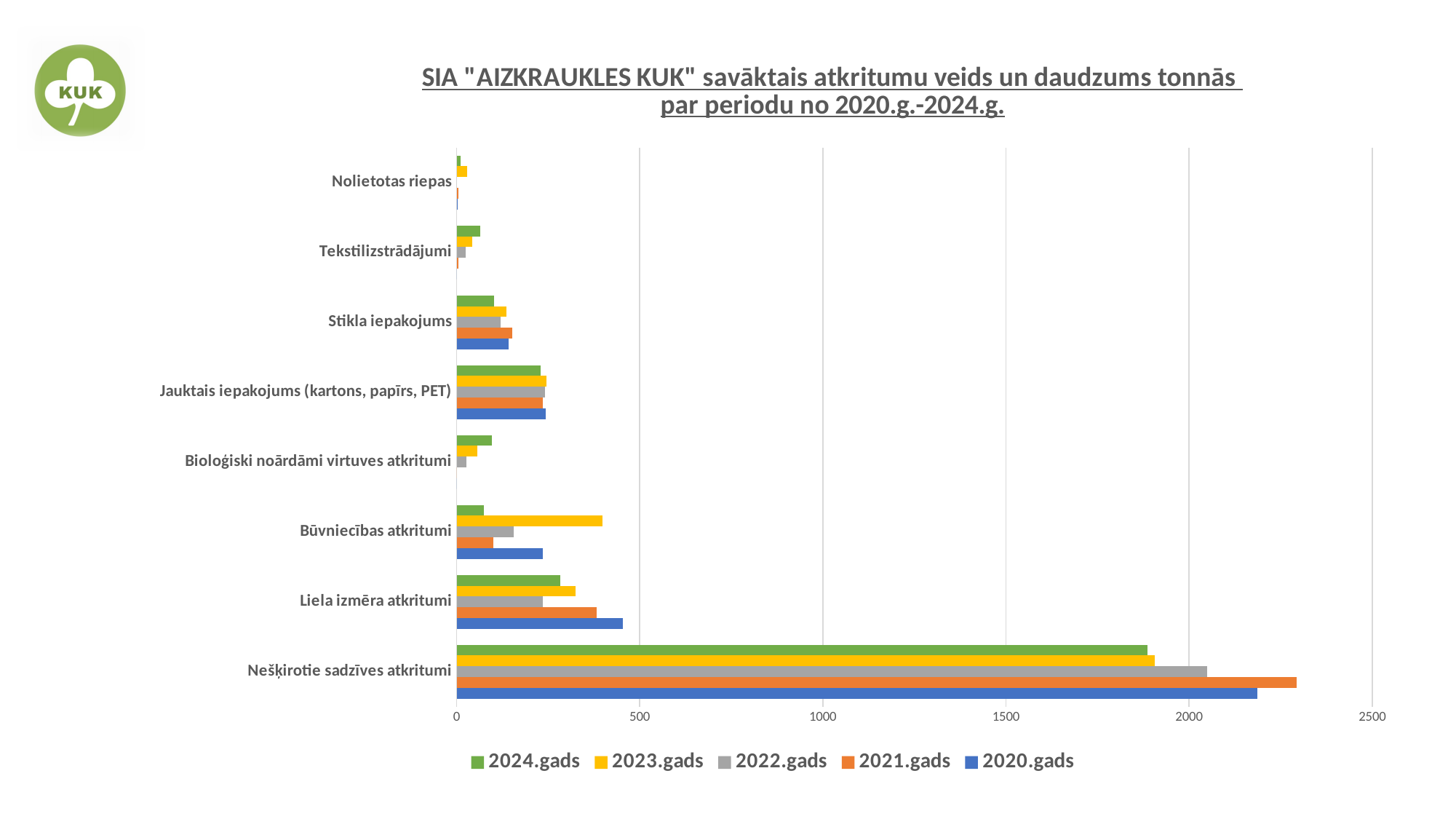
Which colour represents 2022.gads in the legend? grey Which waste category has the largest values in the chart? Nešķirotie sadzīves atkritumi Is the 2024.gads value for Nešķirotie sadzīves atkritumi greater or less than 2000? less How many waste categories are listed on the vertical axis of the chart? 8 How many series does the legend list? 5 Is the 2020.gads value for Liela izmēra atkritumi greater or less than 500? less What kind of chart is shown on the slide? bar chart For Būvniecības atkritumi, which is larger: the 2023.gads value or the 2020.gads value? 2023.gads Is the 2021.gads value for Nešķirotie sadzīves atkritumi greater or less than 2000? greater Which waste category has the smallest values in the chart? Nolietotas riepas For Liela izmēra atkritumi, which is larger: the 2020.gads value or the 2024.gads value? 2020.gads For Nešķirotie sadzīves atkritumi, which year has the highest value? 2021.gads